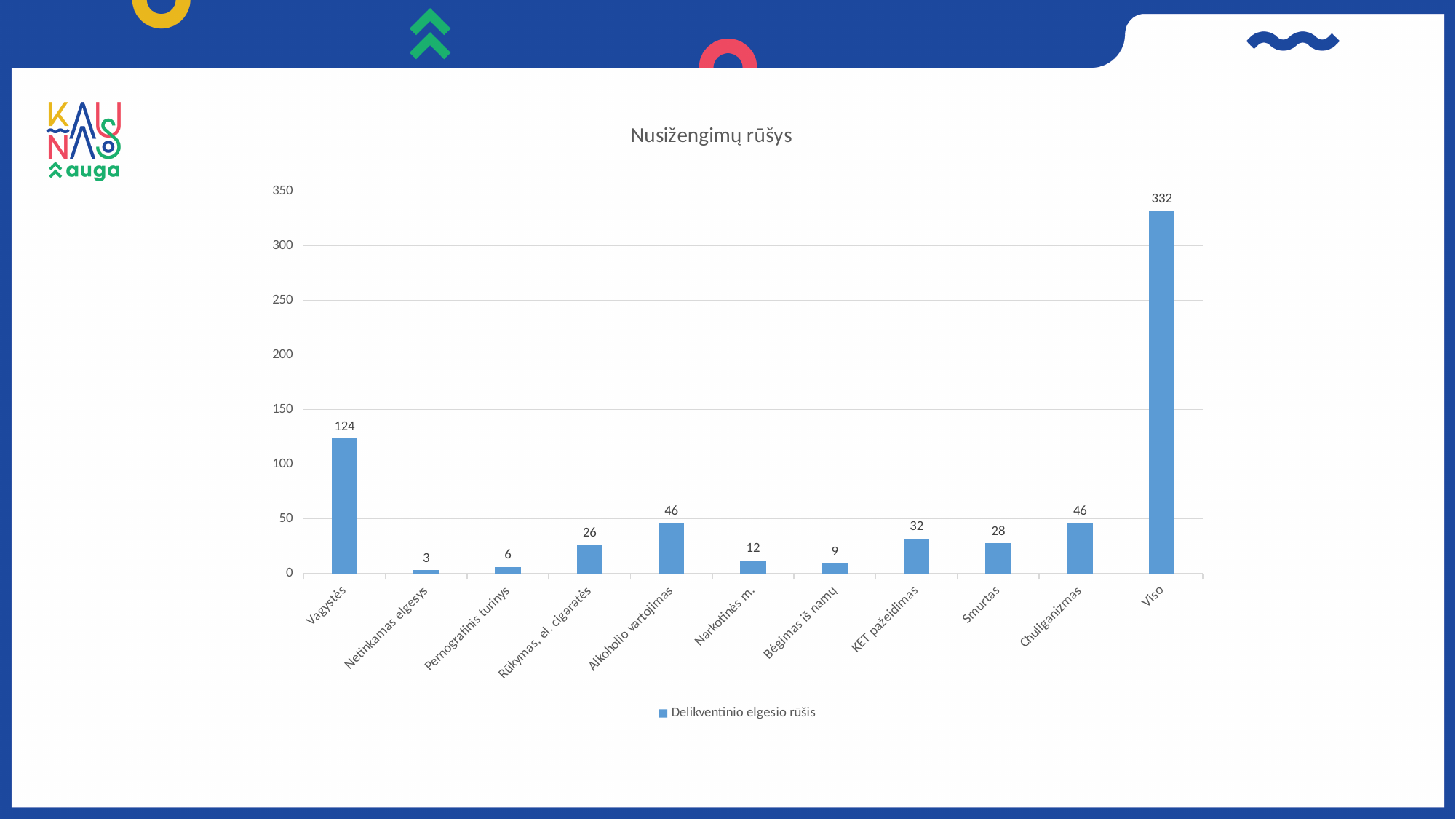
What is the title of the chart? Nusižengimų rūšys What is the difference between the values for Vagystės and Smurtas? 96 What is the value for Viso? 332 What is the value for Alkoholio vartojimas? 46 Which is larger, the value for Rūkymas, el. cigaretės or the value for Narkotinės m.? Rūkymas, el. cigaretės Which category has the highest value? Viso What kind of chart is shown? Bar chart Which category has the lowest value? Netinkamas elgesys What is the value for Vagystės? 124 What is the value for KET pažeidimas? 32 How many series does the legend list? 1 How many categories are shown on the x axis? 11